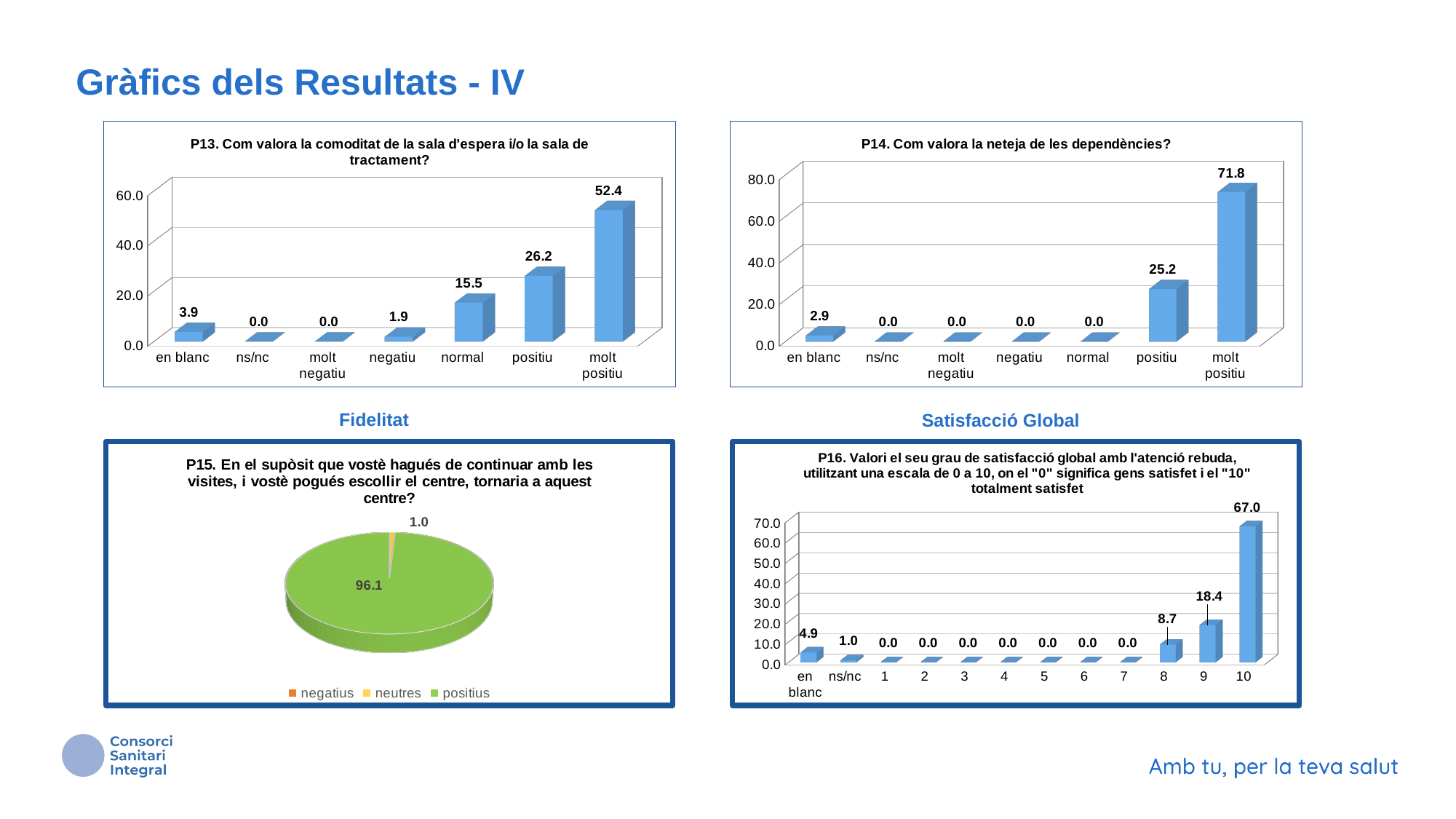
In the P14 chart (top right), which is larger, 'en blanc' or 'positiu'? positiu In the P13 chart (top left), which category has the highest value? molt positiu In the P14 chart (top right), what is the value for 'positiu'? 25.2 In the P16 chart (bottom right), is the value for '10' greater or less than 60.0? greater In the P13 chart (top left), how many categories are shown on the x axis? 7 How many series does the legend of the P15 chart (bottom left) list? 3 In the P13 chart (top left), what is the difference between 'molt positiu' and 'positiu'? 26.2 What kind of chart is the P15 chart (bottom left)? pie chart In the P14 chart (top right), what is the total of 'positiu' and 'molt positiu'? 97.0 In the P13 chart (top left), what is the value for 'molt positiu'? 52.4 In the P15 pie chart (bottom left), what share is labelled for 'positius'? 96.1 In the P16 chart (bottom right), what is the value for '9'? 18.4